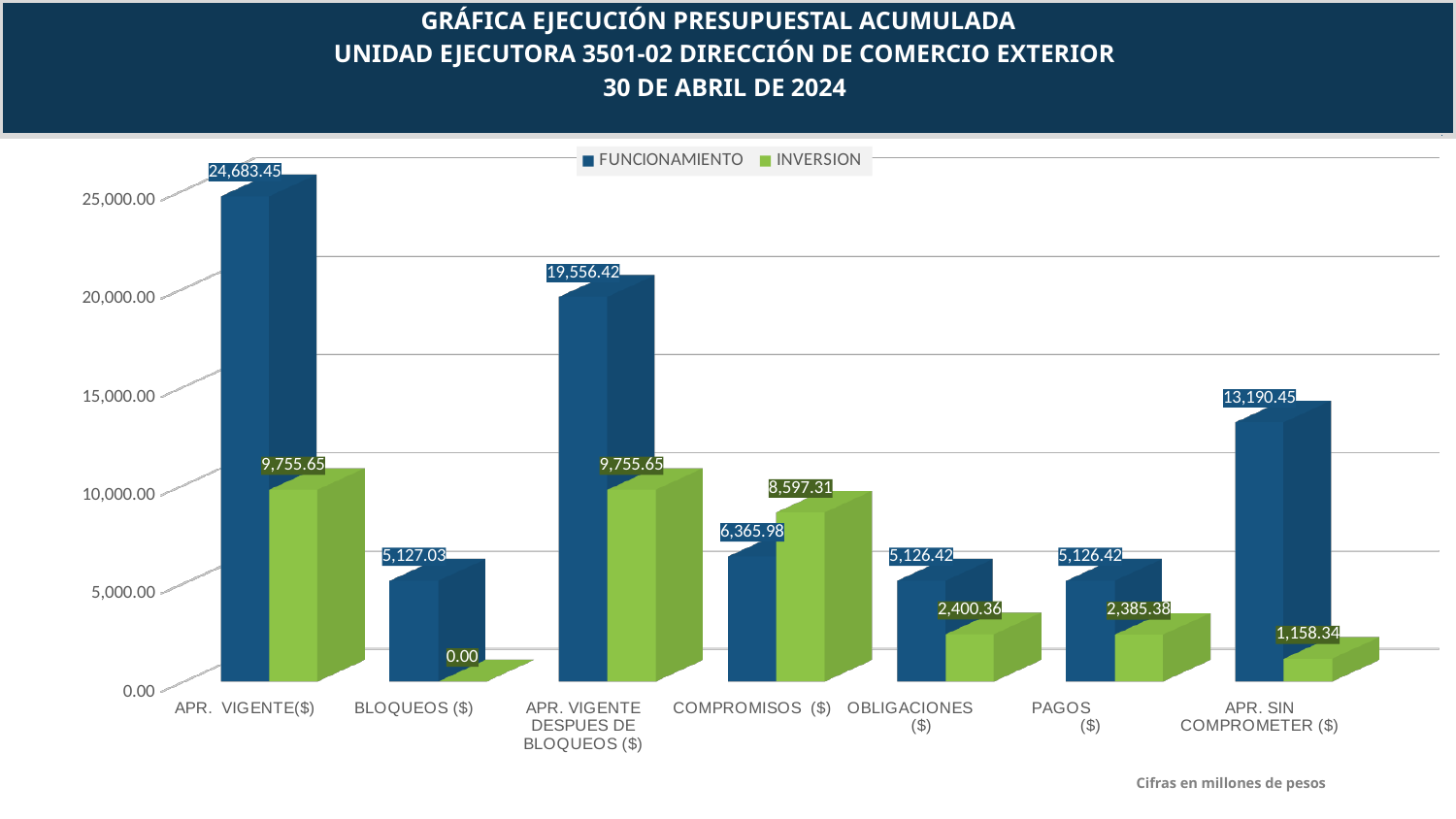
How many categories are shown on the x axis? 7 How many series does the legend list? 2 What is the FUNCIONAMIENTO value for APR. VIGENTE($)? 24,683.45 Which category has the highest FUNCIONAMIENTO value? APR. VIGENTE($) Which category has the lowest INVERSION value? BLOQUEOS ($) What is the INVERSION value for BLOQUEOS ($)? 0.00 What is the INVERSION value for COMPROMISOS ($)? 8,597.31 Is the FUNCIONAMIENTO value for APR. VIGENTE DESPUES DE BLOQUEOS ($) greater or less than 15,000.00? greater What is the FUNCIONAMIENTO value for APR. SIN COMPROMETER ($)? 13,190.45 What is the difference between the FUNCIONAMIENTO and INVERSION values for APR. VIGENTE($)? 14,927.80 What kind of chart is shown on the slide? bar chart For COMPROMISOS ($), which series has the larger value, FUNCIONAMIENTO or INVERSION? INVERSION